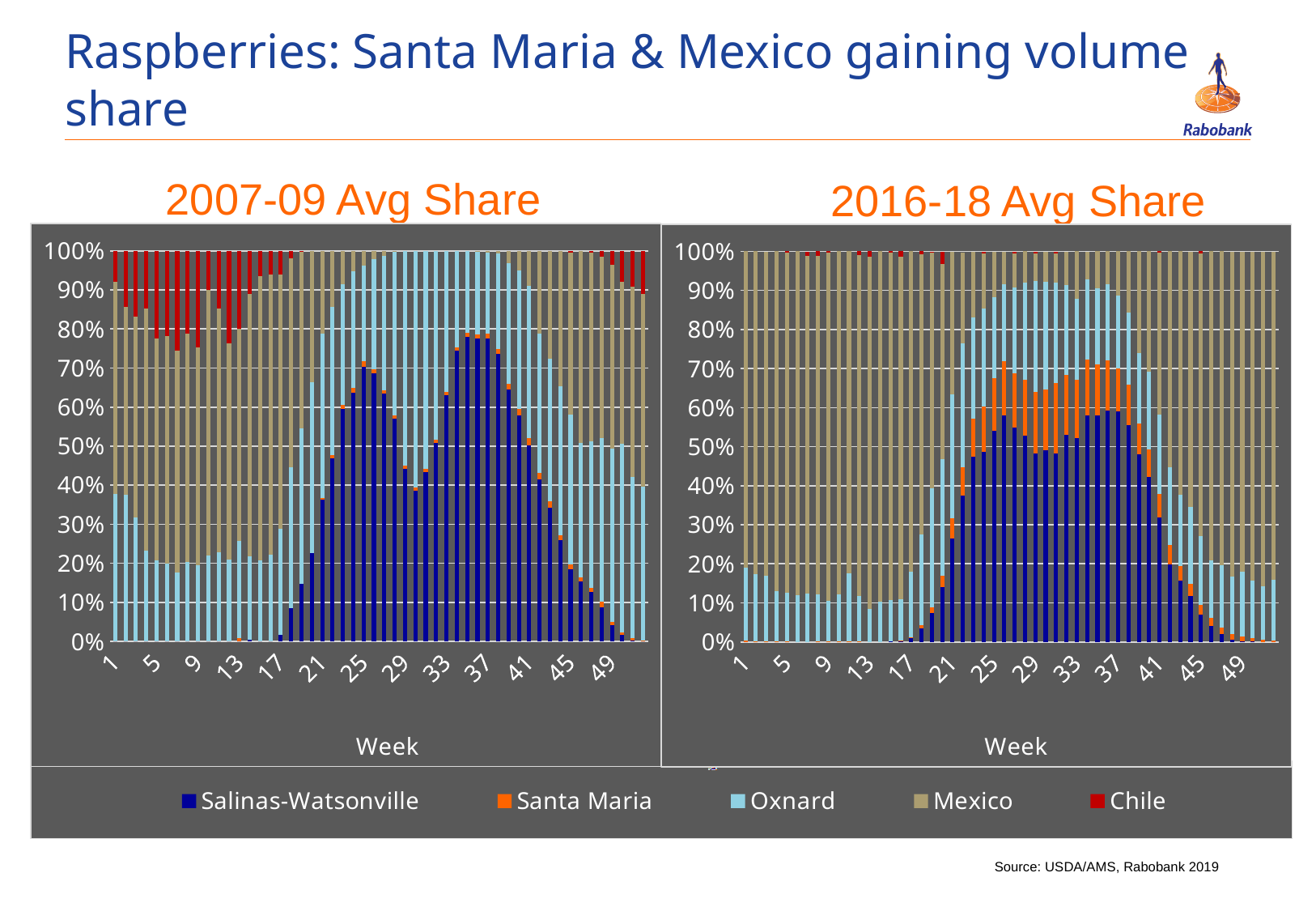
In the 2007-09 Avg Share chart, is the value for Oxnard at week 1 greater or less than 30%? greater In the 2016-18 Avg Share chart, is the value for Salinas-Watsonville at week 25 greater or less than 50%? greater What is the x-axis label on both charts? Week In the 2007-09 Avg Share chart, is the value for Salinas-Watsonville at week 37 greater or less than 70%? greater In the 2007-09 Avg Share chart, does the Salinas-Watsonville share rise or fall from week 19 to week 25? rise What kind of chart is the 2007-09 Avg Share chart? Stacked bar chart In the 2007-09 Avg Share chart, which series is highest at week 37? Salinas-Watsonville In the 2016-18 Avg Share chart, does the Salinas-Watsonville share rise or fall from week 39 to week 47? fall What is the title of the chart on the right? 2016-18 Avg Share How many series does the legend list? 5